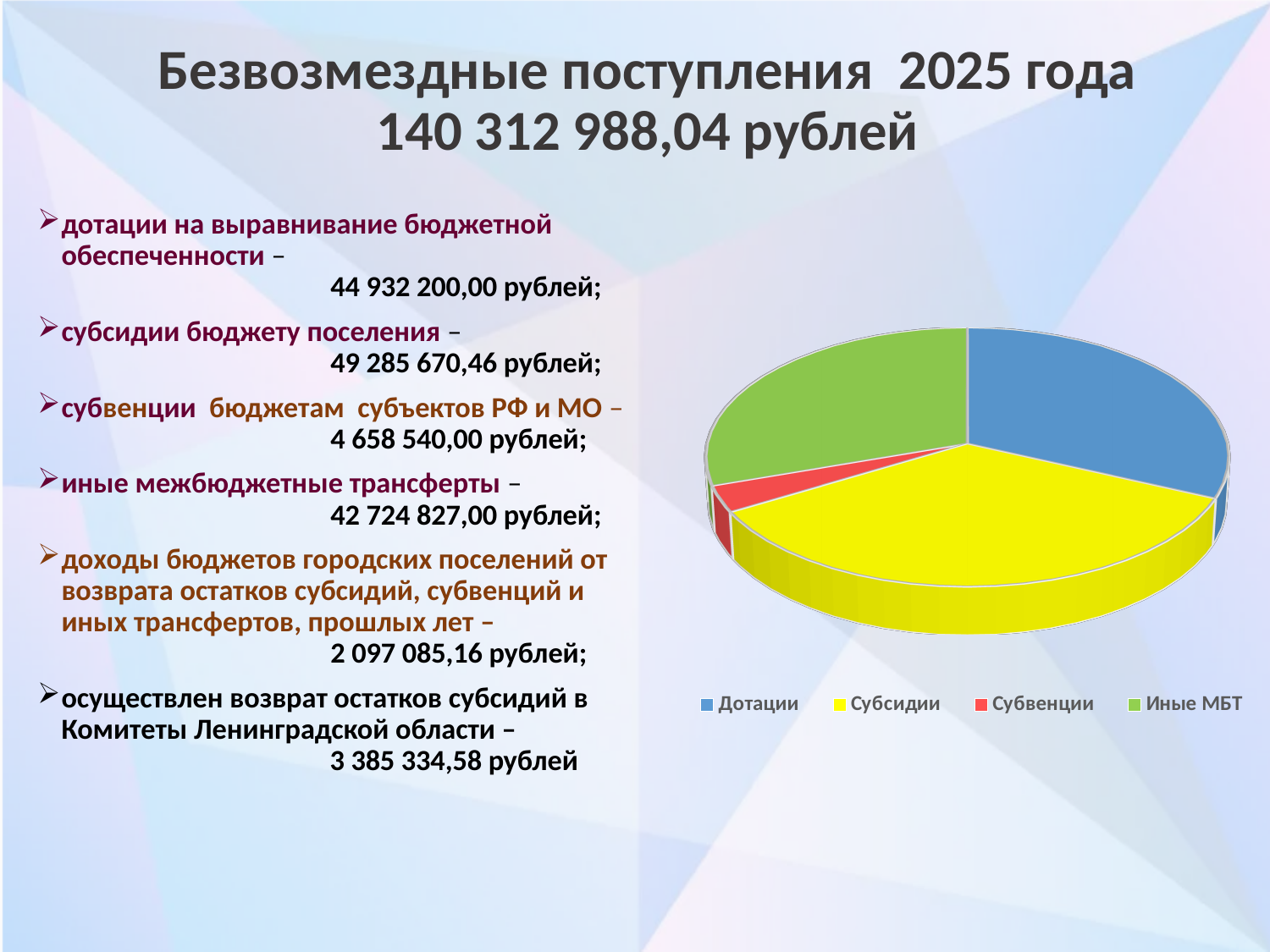
Which category has the largest slice of the pie chart? Субсидии Which slice is larger in the pie chart, Субсидии or Субвенции? Субсидии How many entries does the pie chart's legend list? 4 What colour is the Субсидии slice in the pie chart? yellow Which category has the smallest slice of the pie chart? Субвенции What kind of chart is shown on the slide? pie chart Which slice is larger in the pie chart, Иные МБТ or Субвенции? Иные МБТ How many slices does the pie chart have? 4 Which legend entry is shown in green in the pie chart? Иные МБТ Which slice is larger in the pie chart, Дотации or Субвенции? Дотации